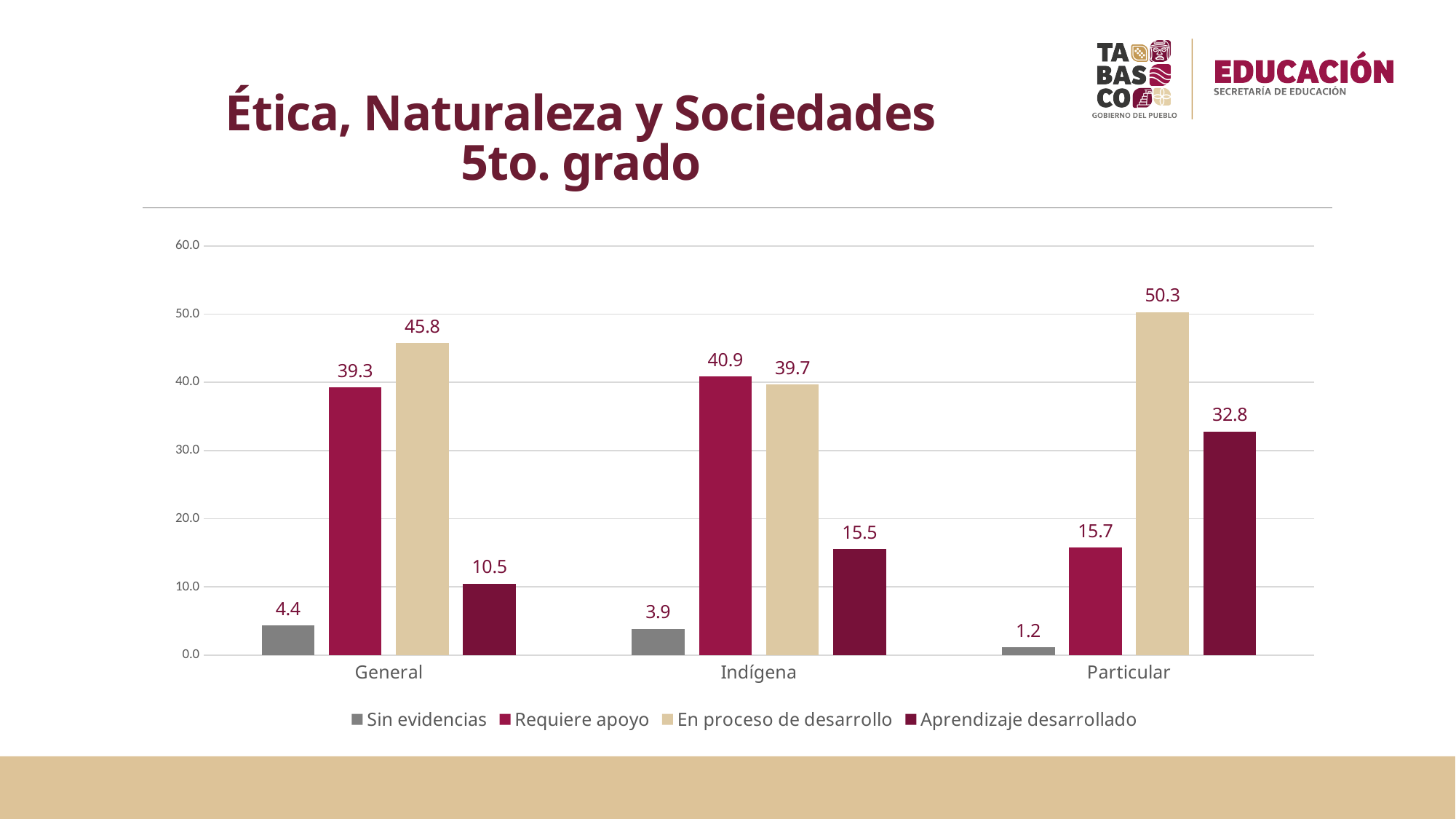
What is the value for "En proceso de desarrollo" in the General category? 45.8 How many categories are shown on the x axis? 3 What kind of chart is shown on the slide? Bar chart What is the value for "Aprendizaje desarrollado" in the Indígena category? 15.5 What is the difference between "En proceso de desarrollo" and "Requiere apoyo" in the Particular category? 34.6 What is the value for "Sin evidencias" in the Particular category? 1.2 Which is larger in the Indígena category: "Requiere apoyo" or "En proceso de desarrollo"? Requiere apoyo How many series does the legend list? 4 What is the title of the slide? Ética, Naturaleza y Sociedades 5to. grado Which category has the highest value for "Aprendizaje desarrollado"? Particular Which category has the lowest value for "Sin evidencias"? Particular Is the value for "En proceso de desarrollo" in the Particular category greater or less than 50.0? greater